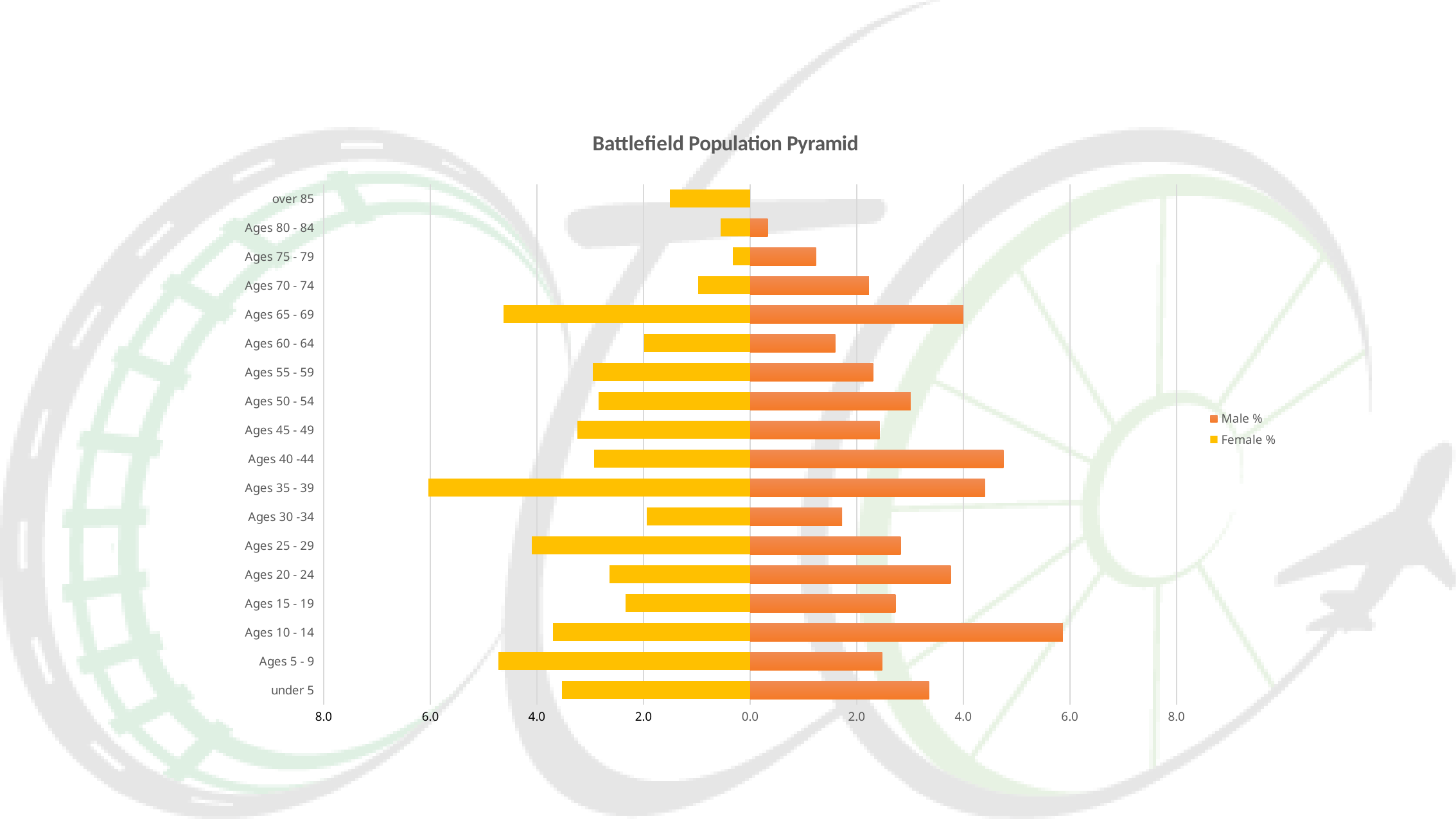
How many age categories are shown on the chart? 18 Which age category has the highest Male % value? Ages 10 - 14 Which colour represents the Female % series? Yellow What is the title of the chart? Battlefield Population Pyramid Is the Female % value for Ages 35 - 39 greater or less than 4.0? greater Which age category has the highest Female % value? Ages 35 - 39 Is the Female % value for over 85 greater or less than 2.0? less How many series does the legend list? 2 Is the Male % value for Ages 80 - 84 greater or less than 2.0? less Which is larger, the Male % value for Ages 10 - 14 or the Male % value for Ages 5 - 9? Ages 10 - 14 What type of chart is shown on the slide? Bar chart